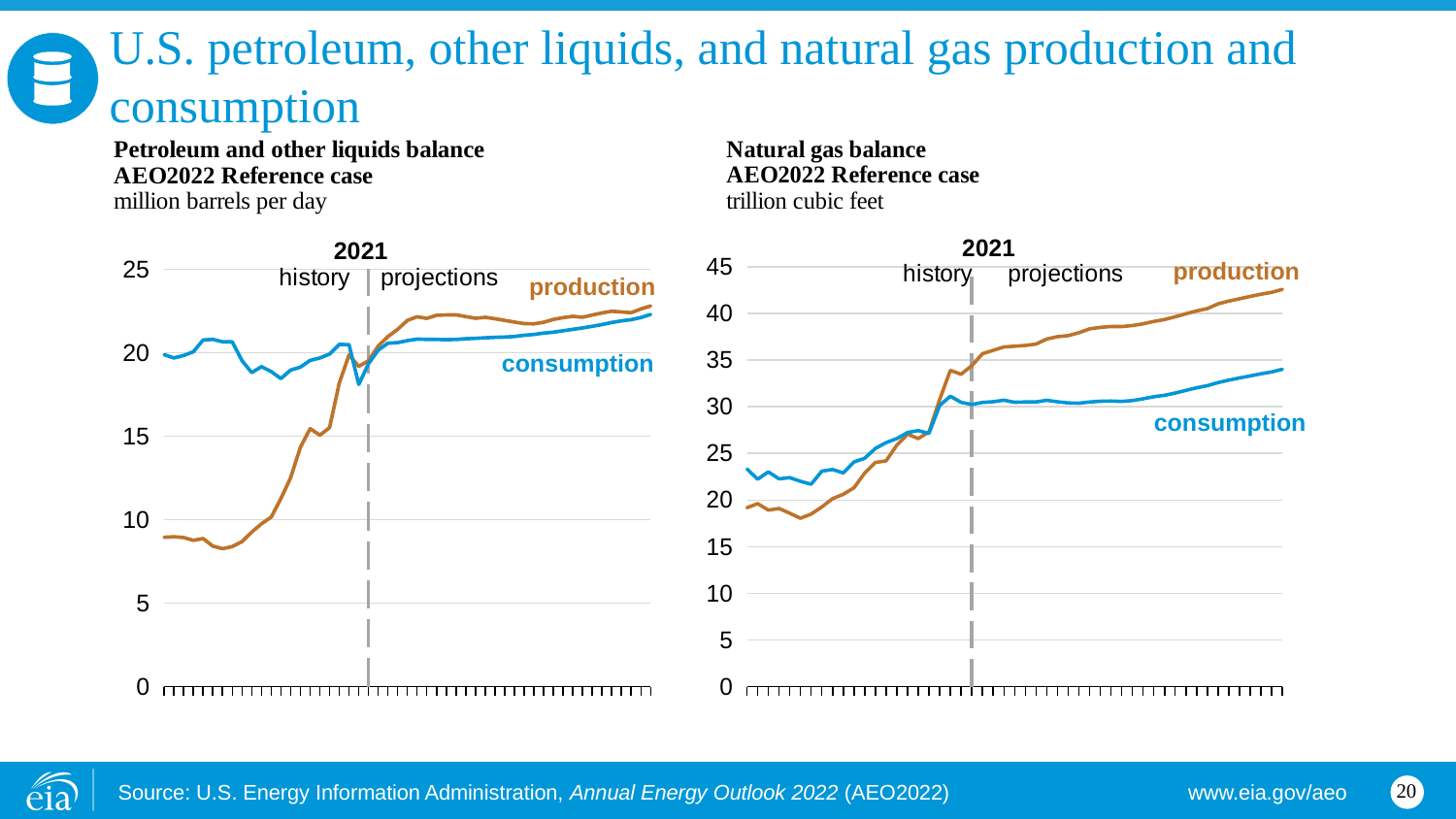
What unit is used on the Natural gas balance chart? trillion cubic feet On the Natural gas balance chart, is the production value at the end of the projection period greater or less than 40? greater On the Petroleum and other liquids balance chart, is the production value at the start of the history period greater or less than 10? less On the Natural gas balance chart, does production rise or fall over the period shown? rise On the Petroleum and other liquids balance chart, is the production value at the end of the projection period greater or less than 20? greater How many series are plotted on the Natural gas balance chart on the right? 2 On the Natural gas balance chart, at the end of the projection period, which is higher: production or consumption? production On the Petroleum and other liquids balance chart, does production rise or fall over the period shown? rise On the Petroleum and other liquids balance chart, at the end of the projection period, which is higher: production or consumption? production On the Petroleum and other liquids balance chart, at the start of the history period, which is higher: production or consumption? consumption What kind of chart is the Petroleum and other liquids balance chart on the left? line chart